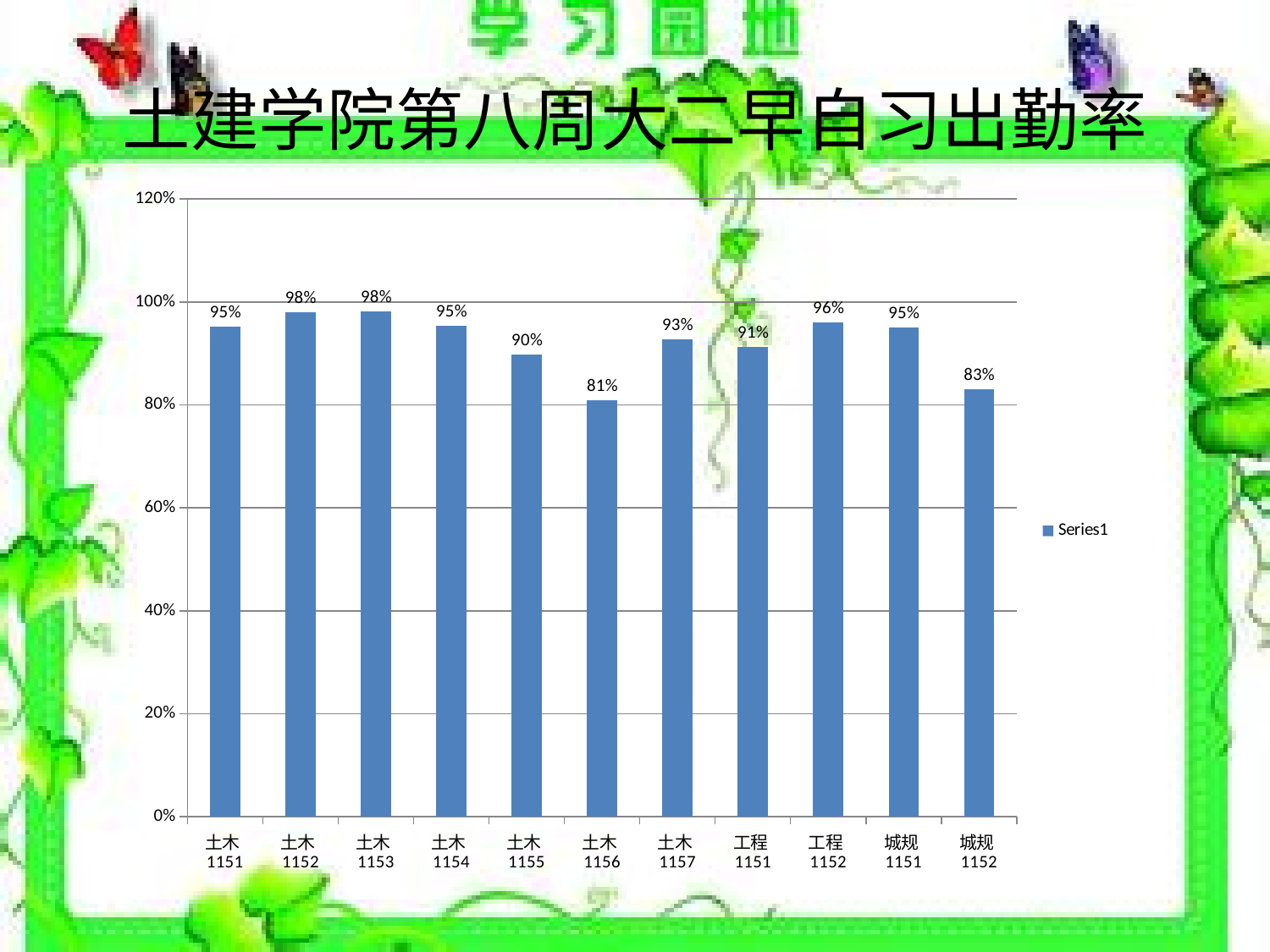
What is the attendance rate for 城规1152? 83% What is the difference between the attendance rates of 工程1152 and 工程1151? 5% What kind of chart is shown on the slide? bar chart What is the difference between the attendance rates of 土木1153 and 土木1156? 17% Which has a higher attendance rate, 土木1157 or 城规1152? 土木1157 What is the highest attendance rate shown on the chart? 98% How many classes are shown on the chart? 11 What is the attendance rate for 工程1152? 96% Which class has the lowest attendance rate? 土木1156 How many series does the legend list? 1 Is the value for 土木1156 greater or less than 100%? less What is the attendance rate for 土木1155? 90%